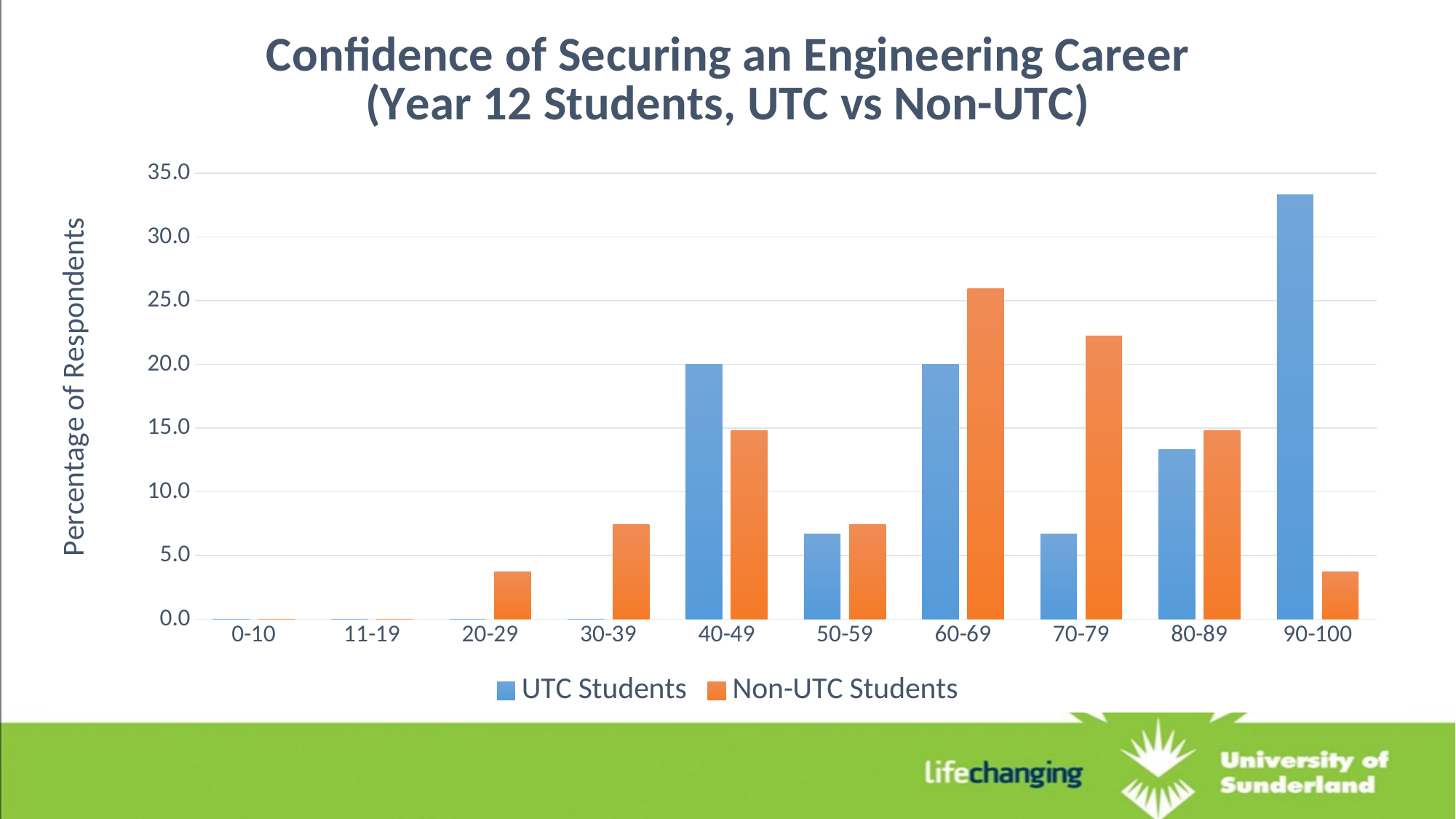
Which category has the highest value for UTC Students? 90-100 Is the value for UTC Students in the 90-100 category greater or less than 30.0? greater What is the label of the vertical axis? Percentage of Respondents In the 90-100 category, which series has the larger value, UTC Students or Non-UTC Students? UTC Students What kind of chart is shown on the slide? bar chart Which category has the highest value for Non-UTC Students? 60-69 Is the value for Non-UTC Students in the 90-100 category greater or less than 5.0? less In the 70-79 category, which series has the larger value, UTC Students or Non-UTC Students? Non-UTC Students What is the value for UTC Students in the 40-49 category? 20.0 Is the value for Non-UTC Students in the 70-79 category greater or less than 20.0? greater How many series does the legend list? 2 How many confidence categories are shown along the x axis? 10